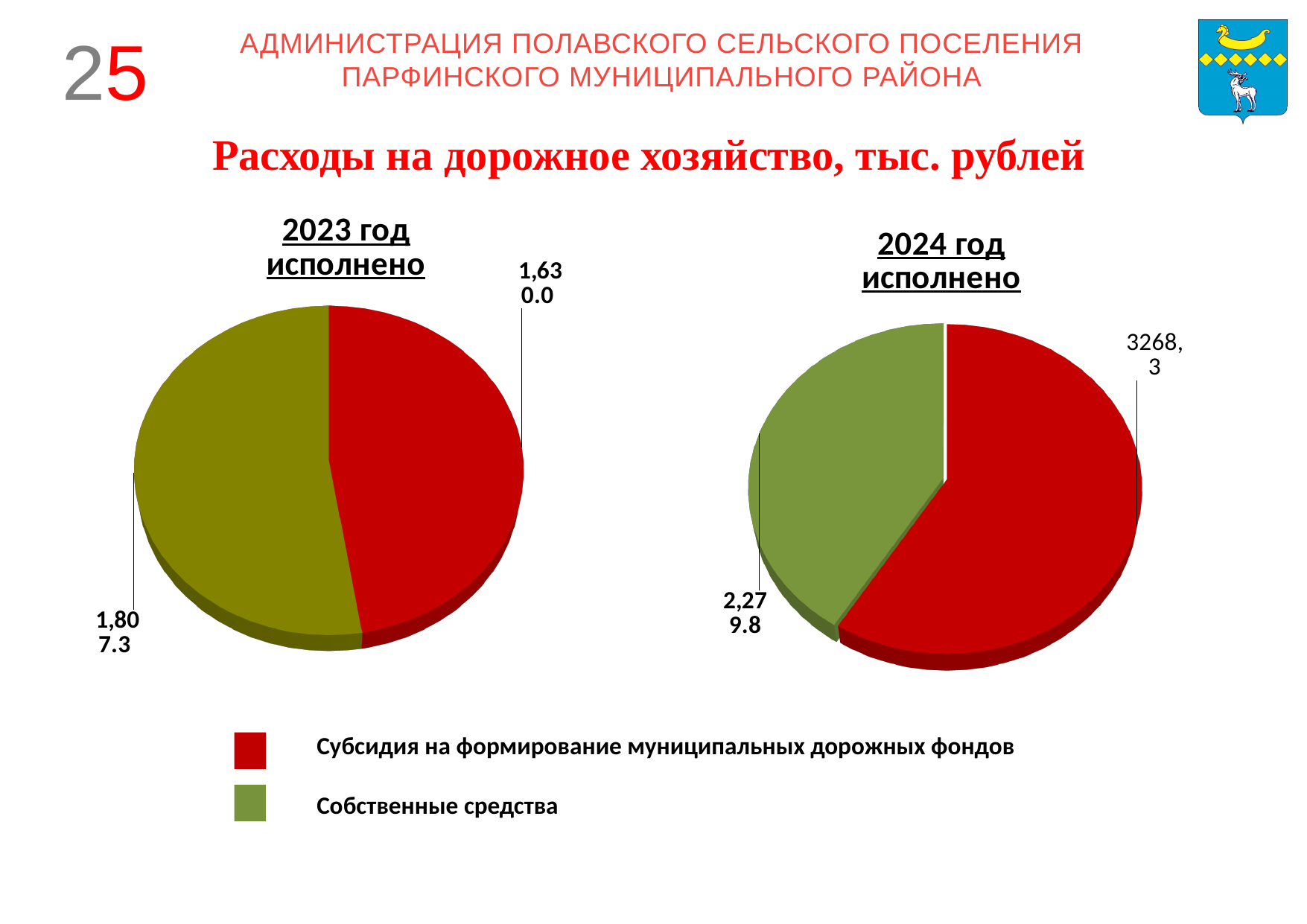
In the 2024 год исполнено pie chart, what is the difference between the subsidy value and the own funds value? 988.5 What type of chart is used on this slide for 2023 год исполнено and 2024 год исполнено? Pie chart In the 2024 год исполнено pie chart, what is the value for Собственные средства? 2,279.8 In the 2024 год исполнено pie chart, which category has the smaller value? Собственные средства In the 2023 год исполнено pie chart, which category has the larger value? Собственные средства In the 2023 год исполнено pie chart, what is the value for Субсидия на формирование муниципальных дорожных фондов? 1,630.0 In the 2024 год исполнено pie chart, what is the value for Субсидия на формирование муниципальных дорожных фондов? 3268,3 In the 2023 год исполнено pie chart, what is the difference between Собственные средства and the subsidy value? 177.3 How many categories does the shared legend list for the pie charts? 2 What is the total of the two values in the 2024 год исполнено pie chart? 5548.1 Is the subsidy value larger in the 2023 год исполнено chart or in the 2024 год исполнено chart? 2024 год исполнено In the 2023 год исполнено pie chart, what is the value for Собственные средства? 1,807.3